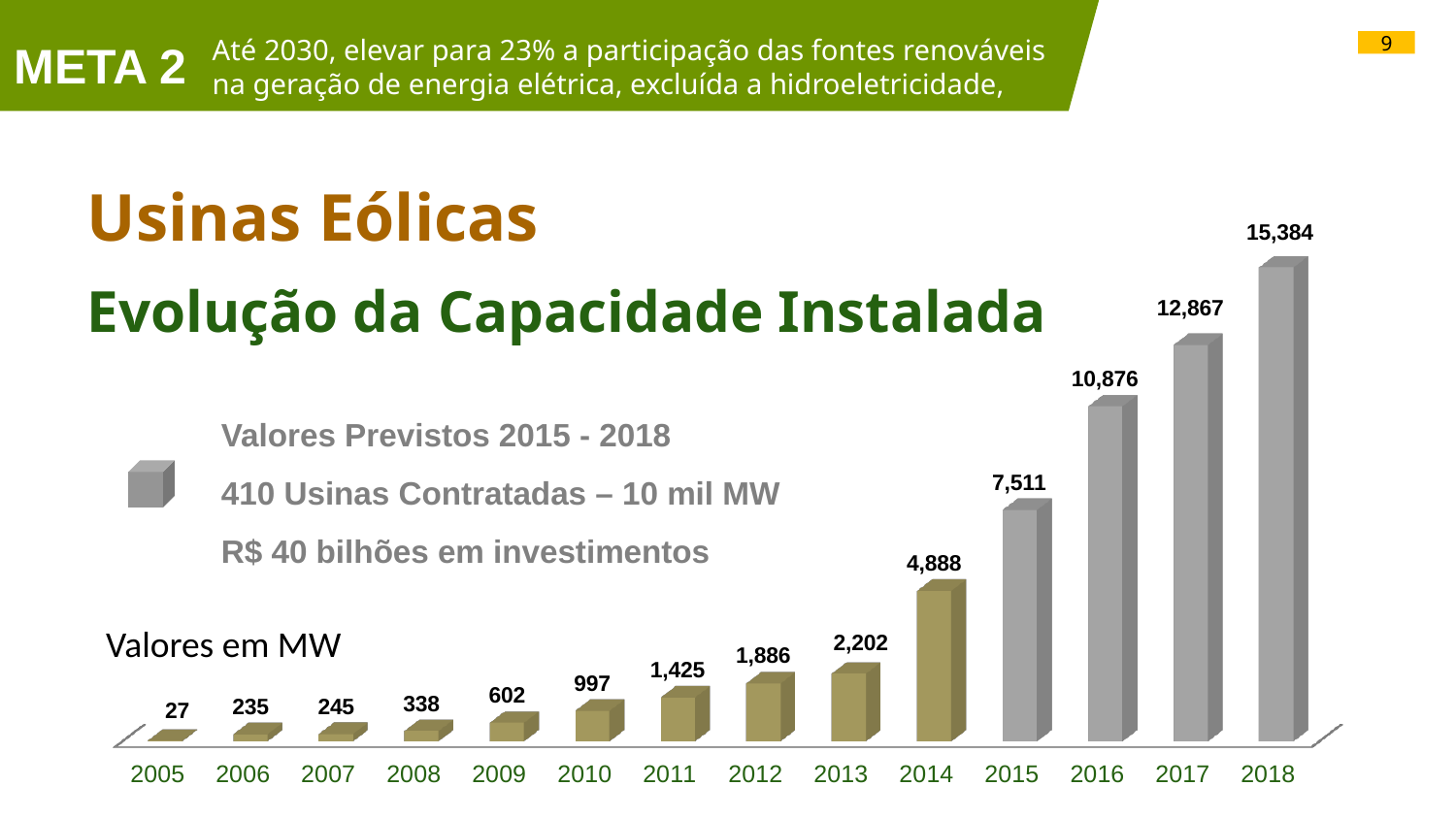
What is the value shown for 2011? 1,425 What is the value shown for 2018? 15,384 What is the difference between the values for 2018 and 2017? 2,517 Which year has the highest value in the chart? 2018 Do the values rise or fall from 2005 to 2018? rise Which year has the lowest value in the chart? 2005 What is the difference between the values for 2015 and 2014? 2,623 How many years are shown on the x axis of the chart? 14 Which is larger, the value for 2009 or the value for 2010? 2010 What kind of chart is shown on the slide? bar chart What is the installed capacity value shown for 2014? 4,888 What is the value shown for 2005? 27